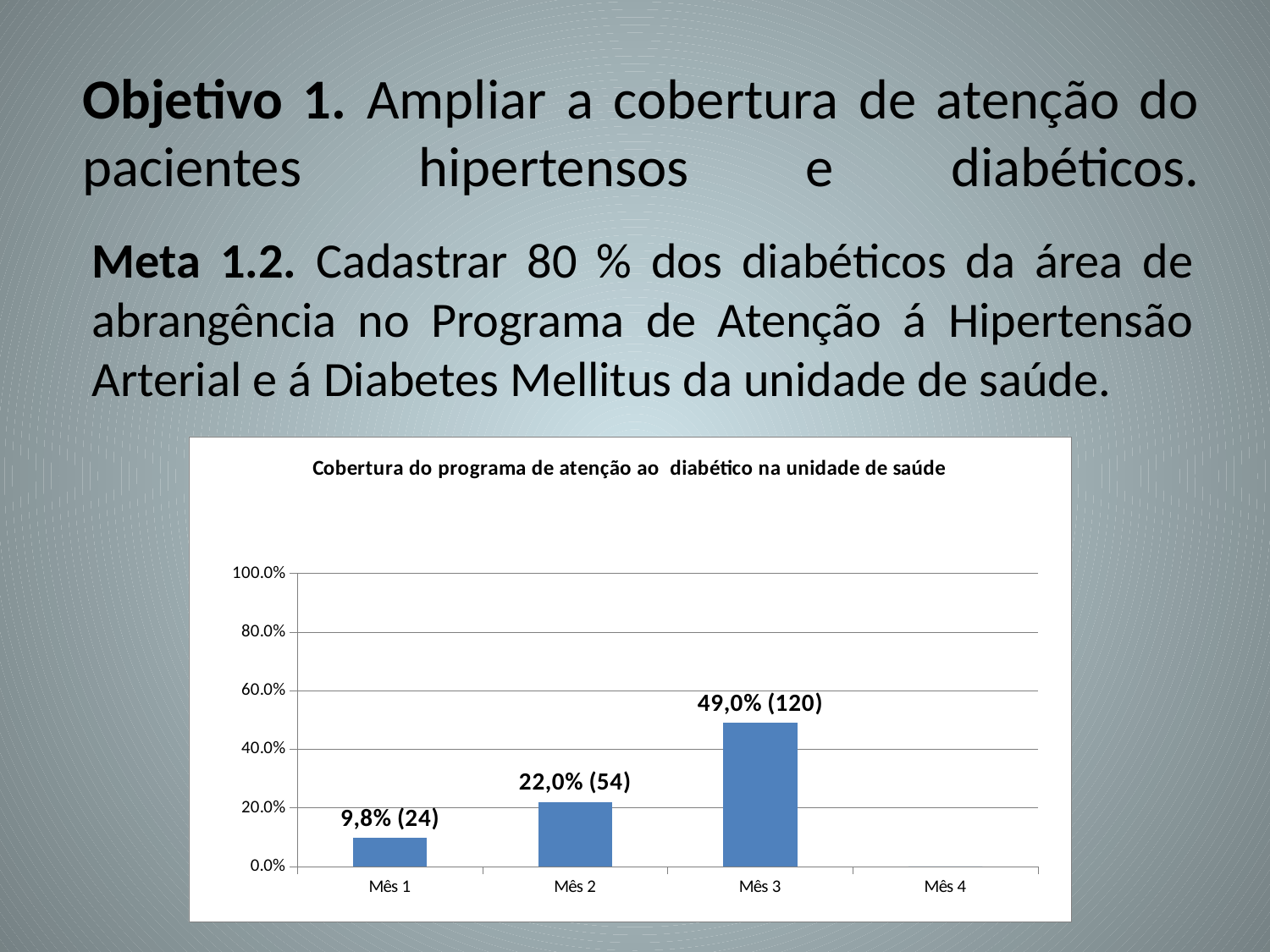
Is the value for Mês 3 greater or less than 40.0%? greater Do the coverage values rise or fall from Mês 1 to Mês 3? Rise What kind of chart is shown on the slide? Bar chart What is the data label shown for Mês 2? 22,0% (54) What is the data label shown for Mês 3? 49,0% (120) Which is larger, the coverage for Mês 2 or for Mês 1? Mês 2 Which month has the highest coverage value? Mês 3 What is the data label shown for Mês 1? 9,8% (24) Among the months with a plotted bar, which has the lowest coverage value? Mês 1 What is the title of the chart? Cobertura do programa de atenção ao diabético na unidade de saúde What is the difference in percentage points between the coverage for Mês 3 and Mês 2? 27,0% How many month categories are shown on the x axis? 4